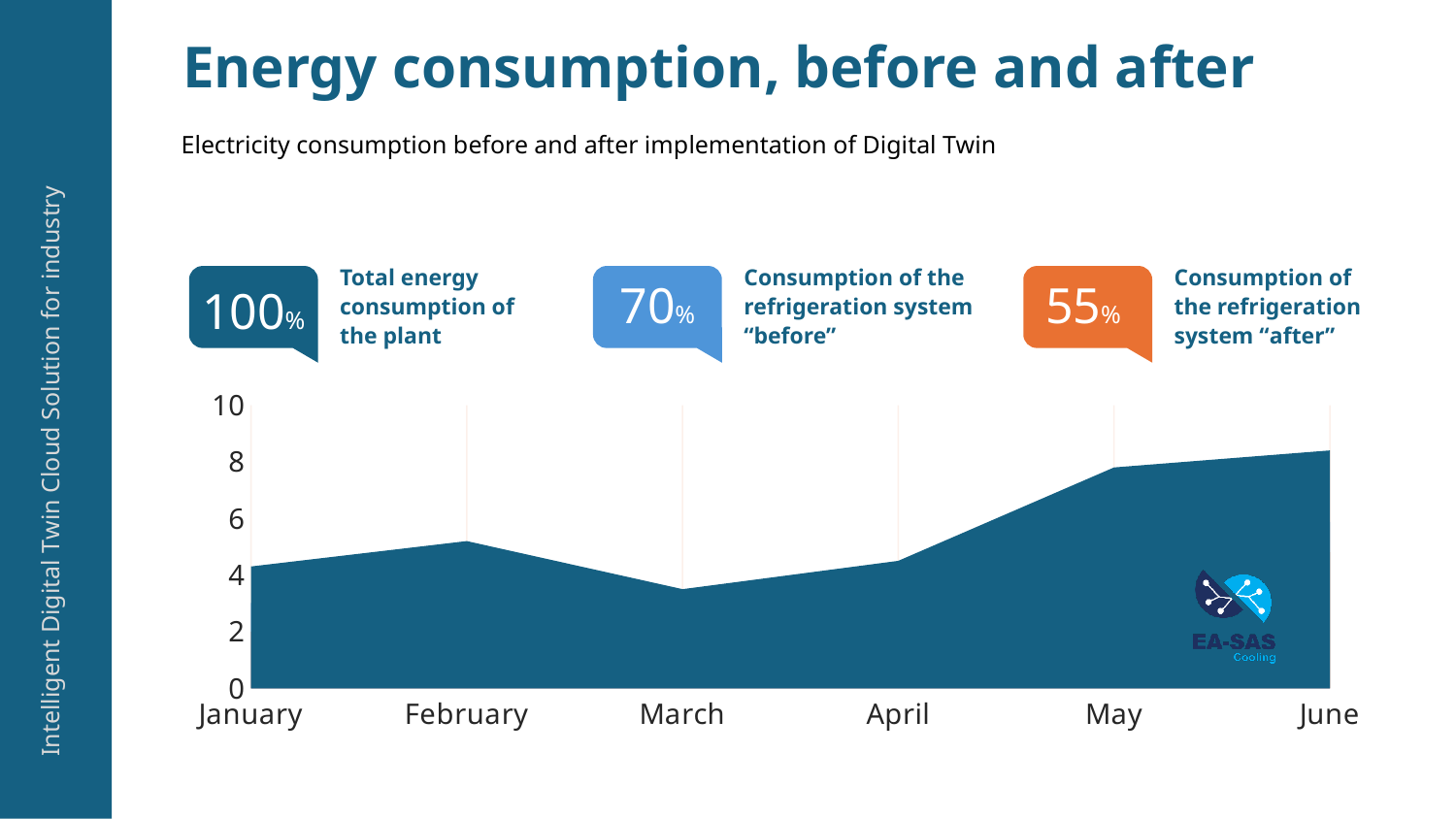
Which month has the lowest value in the chart? March Is the value for June greater or less than 8? greater Do the values rise or fall from March to June? rise Is the value for March greater or less than 4? less Which is larger, the value for June or the value for March? June How many months are shown on the x axis of the chart? 6 What is the title of the slide containing the chart? Energy consumption, before and after Is the value for May greater or less than 6? greater Which is larger, the value for May or the value for February? May Which month has the highest value in the chart? June What kind of chart is shown on the slide? Area chart